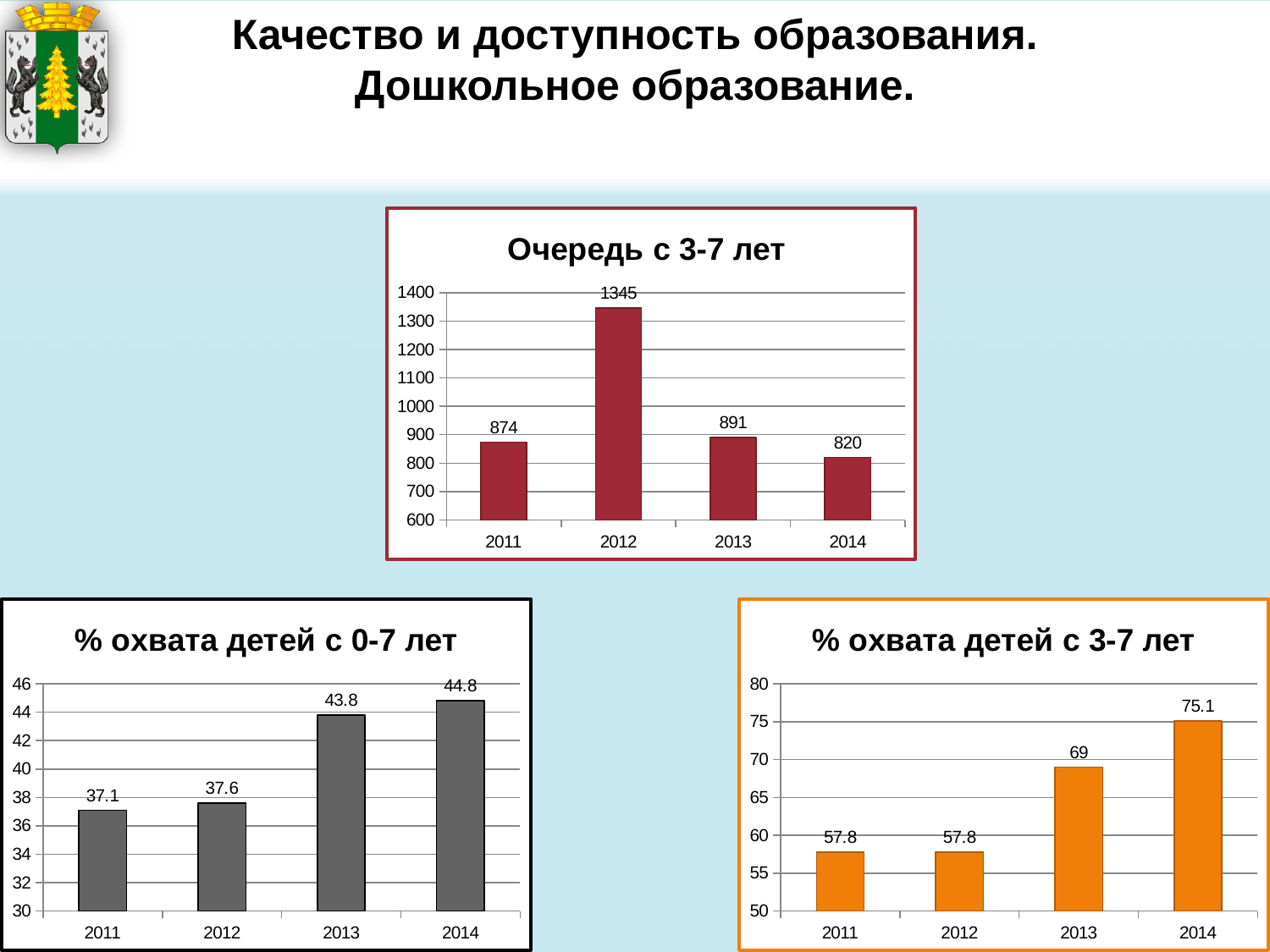
In the chart titled "Очередь с 3-7 лет", what is the difference between the values for 2012 and 2011? 471 In the chart titled "Очередь с 3-7 лет", which year has the lowest value? 2014 In the chart titled "% охвата детей с 3-7 лет", what is the value for 2014? 75.1 In the chart titled "% охвата детей с 3-7 лет", which is larger, the value for 2013 or the value for 2012? 2013 In the chart titled "% охвата детей с 0-7 лет", what is the value for 2013? 43.8 In the chart titled "% охвата детей с 0-7 лет", what is the difference between the values for 2014 and 2011? 7.7 In the chart titled "Очередь с 3-7 лет", how many bars are plotted? 4 In the chart titled "Очередь с 3-7 лет", what is the value for 2012? 1345 In the chart titled "% охвата детей с 0-7 лет", do the values rise or fall from 2011 to 2014? rise In the chart titled "% охвата детей с 0-7 лет", which year has the highest value? 2014 What colour are the bars in the chart titled "% охвата детей с 3-7 лет"? orange What type of chart is the one titled "% охвата детей с 3-7 лет"? bar chart